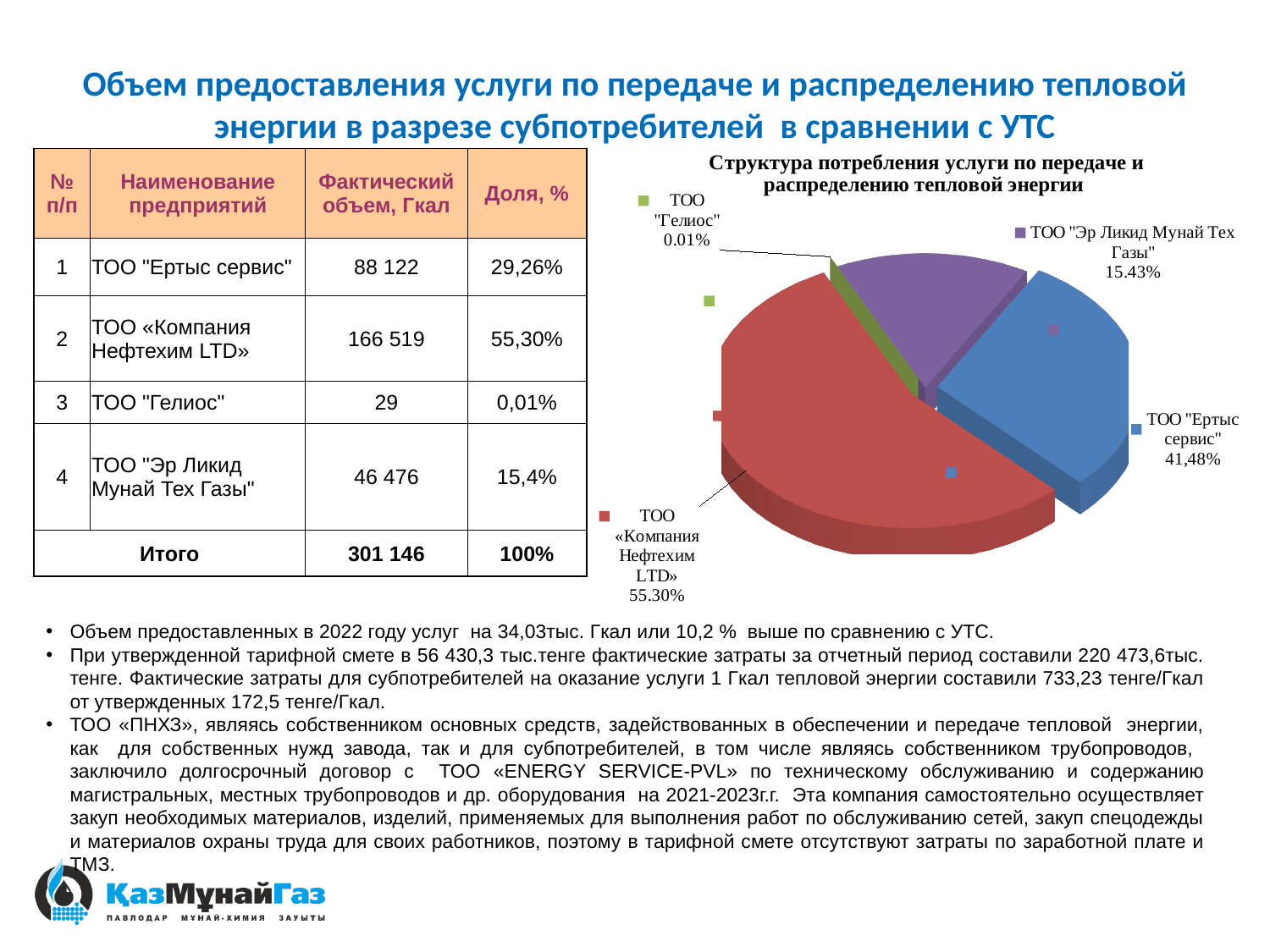
Which company has the smallest slice in the pie chart? ТОО "Гелиос" In the pie chart, which slice is larger: ТОО "Ертыс сервис" or ТОО "Эр Ликид Мунай Тех Газы"? ТОО "Ертыс сервис" What is the title of the pie chart? Структура потребления услуги по передаче и распределению тепловой энергии What share does the pie chart show for ТОО "Гелиос"? 0.01% What share does the pie chart show for ТОО "Эр Ликид Мунай Тех Газы"? 15.43% In the pie chart, what is the difference between the shares of ТОО «Компания Нефтехим LTD» and ТОО "Эр Ликид Мунай Тех Газы"? 39.87% Which company has the largest slice in the pie chart? ТОО «Компания Нефтехим LTD» How many slices does the pie chart have? 4 What share does the pie chart show for ТОО "Ертыс сервис"? 41,48% What kind of chart is shown on the slide? pie chart What colour is the slice for ТОО «Компания Нефтехим LTD» in the pie chart? red